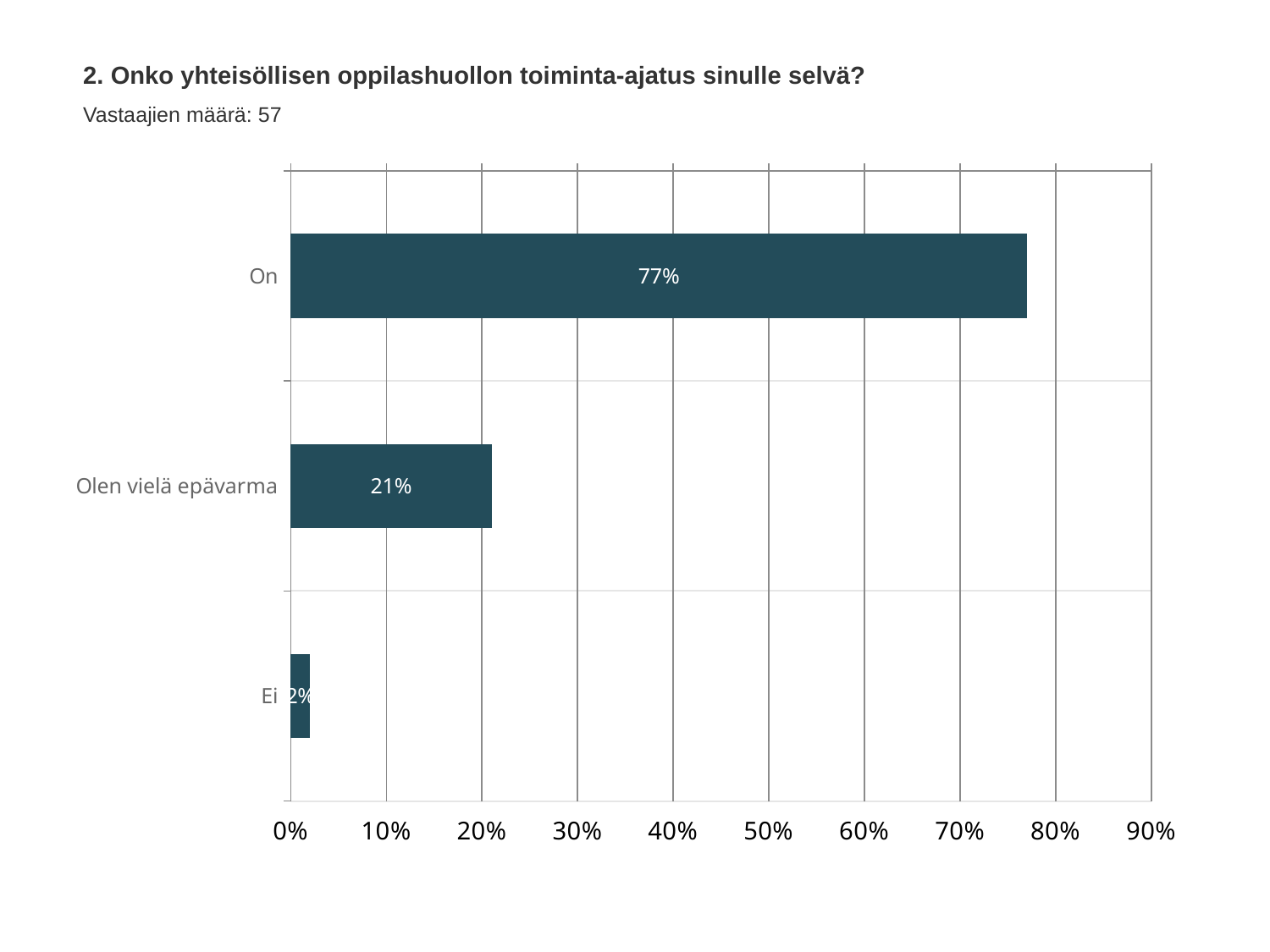
Which category has the highest value? On What is the value for "On"? 77% Is the value for "On" greater or less than 70%? greater What is the difference between the values for "On" and "Olen vielä epävarma"? 56% What is the value for "Ei"? 2% Which is larger, the value for "Olen vielä epävarma" or the value for "Ei"? Olen vielä epävarma Which category has the lowest value? Ei What is the value for "Olen vielä epävarma"? 21% How many respondents (Vastaajien määrä) are reported on the slide? 57 How many categories are shown in the chart? 3 Is the value for "Olen vielä epävarma" greater or less than 30%? less What kind of chart is shown on the slide? bar chart